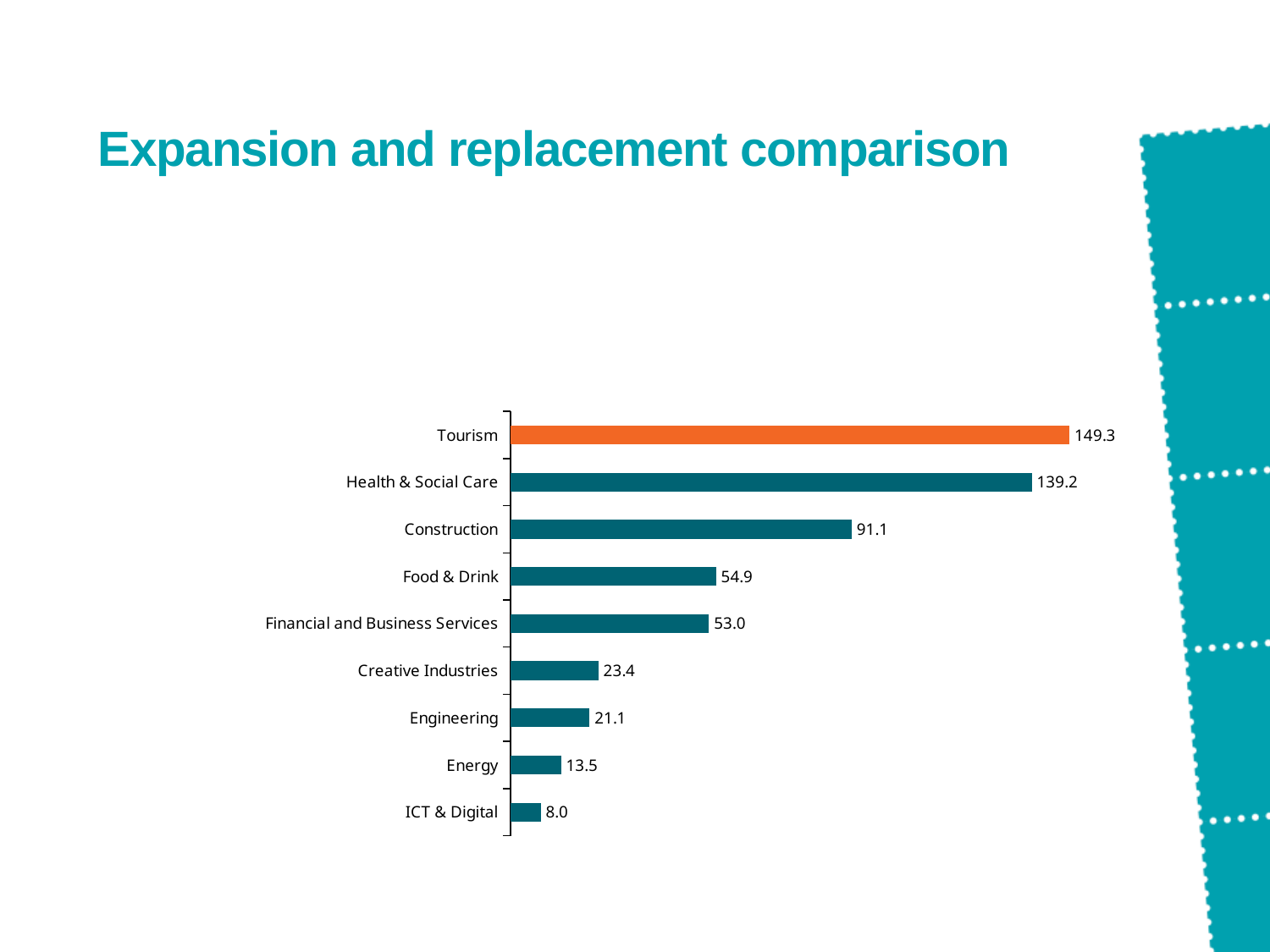
What is the value for Tourism? 149.3 How many categories are shown in the chart? 9 Which category has the highest value? Tourism What kind of chart is shown on the slide? Bar chart Which category has the lowest value? ICT & Digital What is the difference between the values for Tourism and Health & Social Care? 10.1 What is the difference between the values for Construction and Food & Drink? 36.2 What is the value for Construction? 91.1 Which category's bar is coloured orange rather than teal? Tourism What is the title of the slide? Expansion and replacement comparison What is the value for Energy? 13.5 Which is larger, the value for Creative Industries or the value for Engineering? Creative Industries